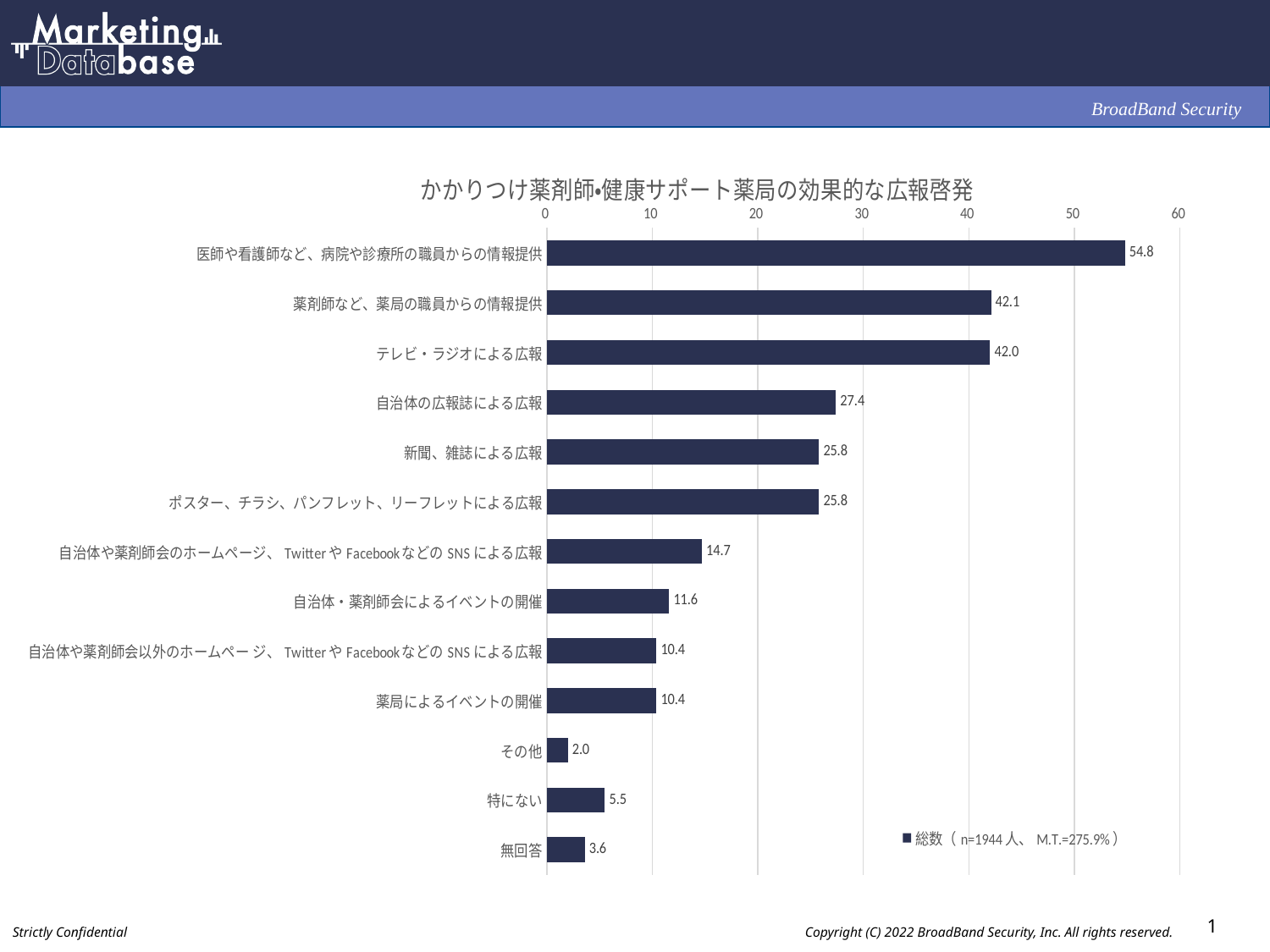
How many categories are shown in the chart? 13 Which category has the highest value? 医師や看護師など、病院や診療所の職員からの情報提供 Which is larger, the value for 特にない or the value for 無回答? 特にない What kind of chart is shown on the slide? bar chart What is the difference between the values for 自治体の広報誌による広報 and 新聞、雑誌による広報? 1.6 What is the value for 自治体・薬剤師会によるイベントの開催? 11.6 What is the title of the chart? かかりつけ薬剤師•健康サポート薬局の効果的な広報啓発 What is the value for テレビ・ラジオによる広報? 42.0 Which category has the lowest value? その他 What is the value for 医師や看護師など、病院や診療所の職員からの情報提供? 54.8 Is the value for 自治体や薬剤師会のホームページ、TwitterやFacebookなどのSNSによる広報 greater or less than 20? less What is the difference between the values for 医師や看護師など、病院や診療所の職員からの情報提供 and 薬剤師など、薬局の職員からの情報提供? 12.7